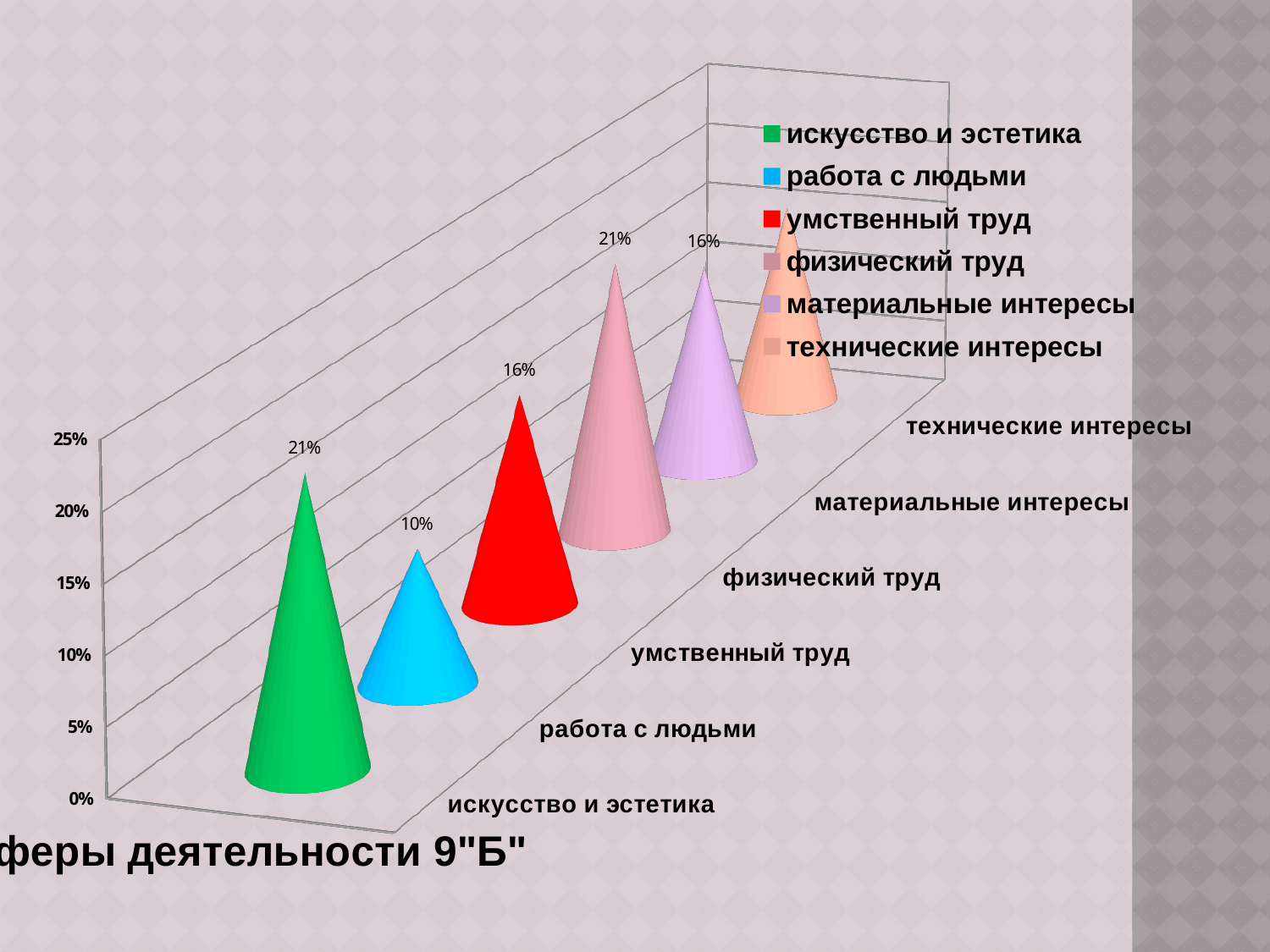
How many categories are shown on the chart? 6 Which is larger, the value for умственный труд or the value for работа с людьми? умственный труд What colour is the cone for искусство и эстетика? green Is the value for работа с людьми greater or less than 15%? less What is the value for материальные интересы? 16% What is the value for физический труд? 21% How many entries does the legend list? 6 What is the value for умственный труд? 16% What is the value for работа с людьми? 10% What is the difference between the values for искусство и эстетика and работа с людьми? 11% What is the difference between the values for физический труд and материальные интересы? 5% What is the value for искусство и эстетика? 21%